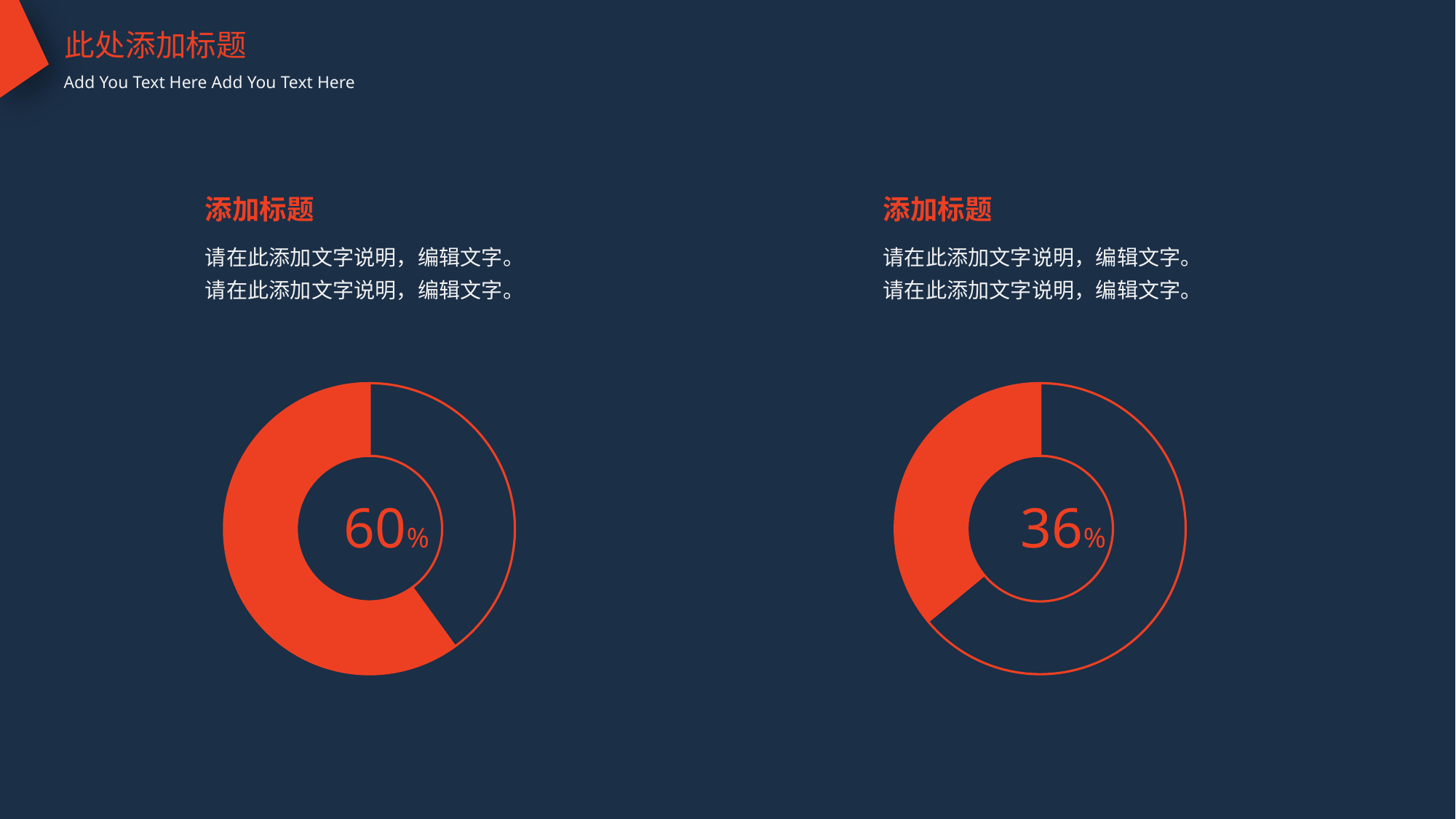
On the left donut chart, what share of the ring is filled in orange? 60% How many donut charts are on the slide? 2 What percentage is shown in the centre of the left donut chart? 60% Which chart shows the larger percentage, the left one or the right one? the left one What percentage is shown in the centre of the right donut chart? 36% Is the value on the left donut chart greater or less than 50%? greater On the right donut chart, what share of the ring is filled in orange? 36% What colour is the filled segment of the donut charts? orange What is the difference between the percentage on the left chart and the percentage on the right chart? 24% Is the value on the right donut chart greater or less than 50%? less Which chart has the smaller filled segment, the left one or the right one? the right one What kind of chart is used on the left side of the slide? donut chart